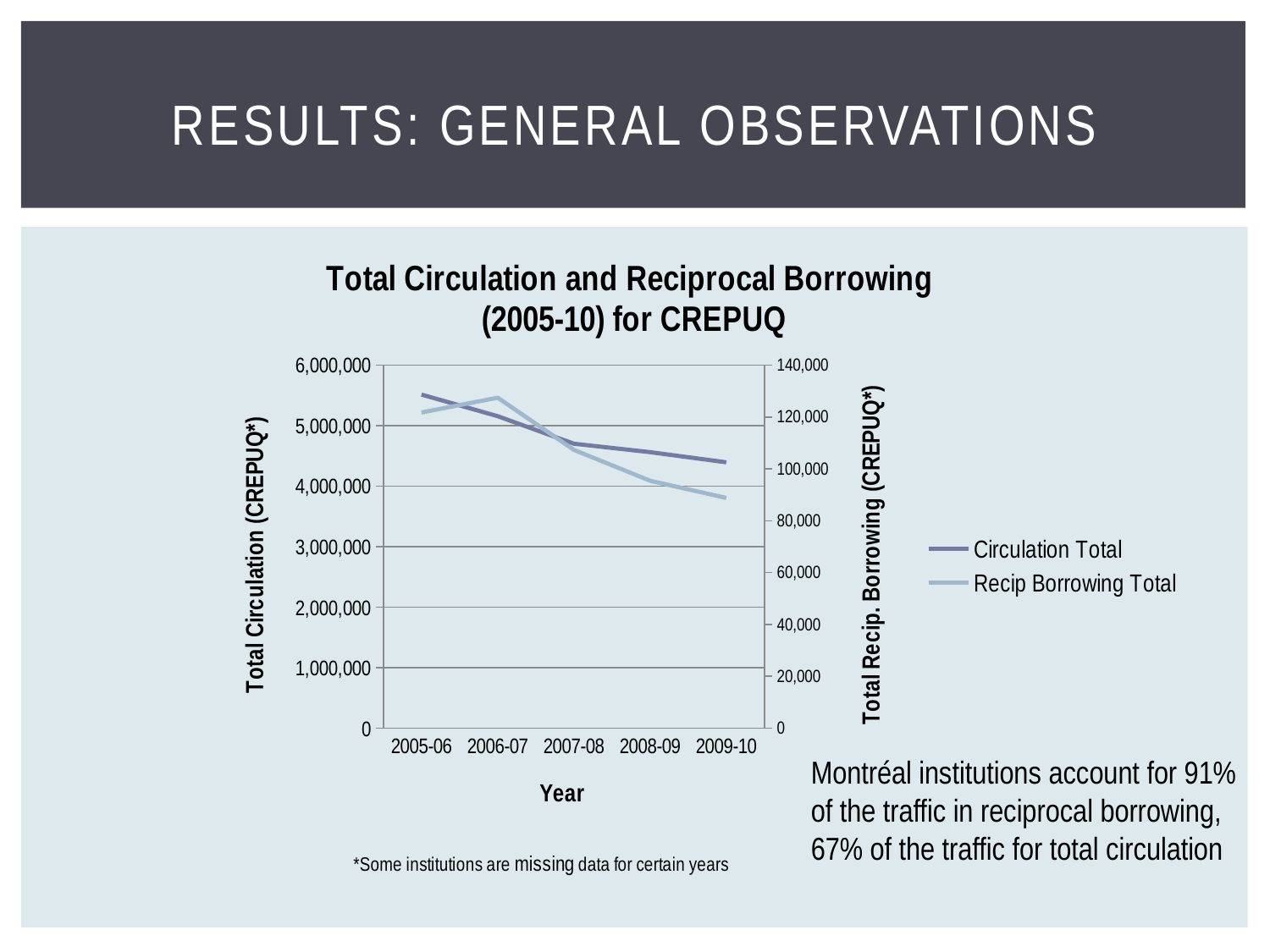
Is the Circulation Total for 2005-06 greater or less than 5,000,000? greater What kind of chart is shown on the slide? line chart How many series does the legend list? 2 What is the label of the right-hand vertical axis? Total Recip. Borrowing (CREPUQ*) Which year has the highest Recip Borrowing Total? 2006-07 Does the Circulation Total series rise or fall from 2005-06 to 2009-10? fall Which year has the highest Circulation Total? 2005-06 How many years are plotted along the x axis? 5 Which year has the lowest Circulation Total? 2009-10 What is the title of the chart? Total Circulation and Reciprocal Borrowing (2005-10) for CREPUQ Is the Recip Borrowing Total for 2009-10 greater or less than 100,000? less Which year has the lowest Recip Borrowing Total? 2009-10